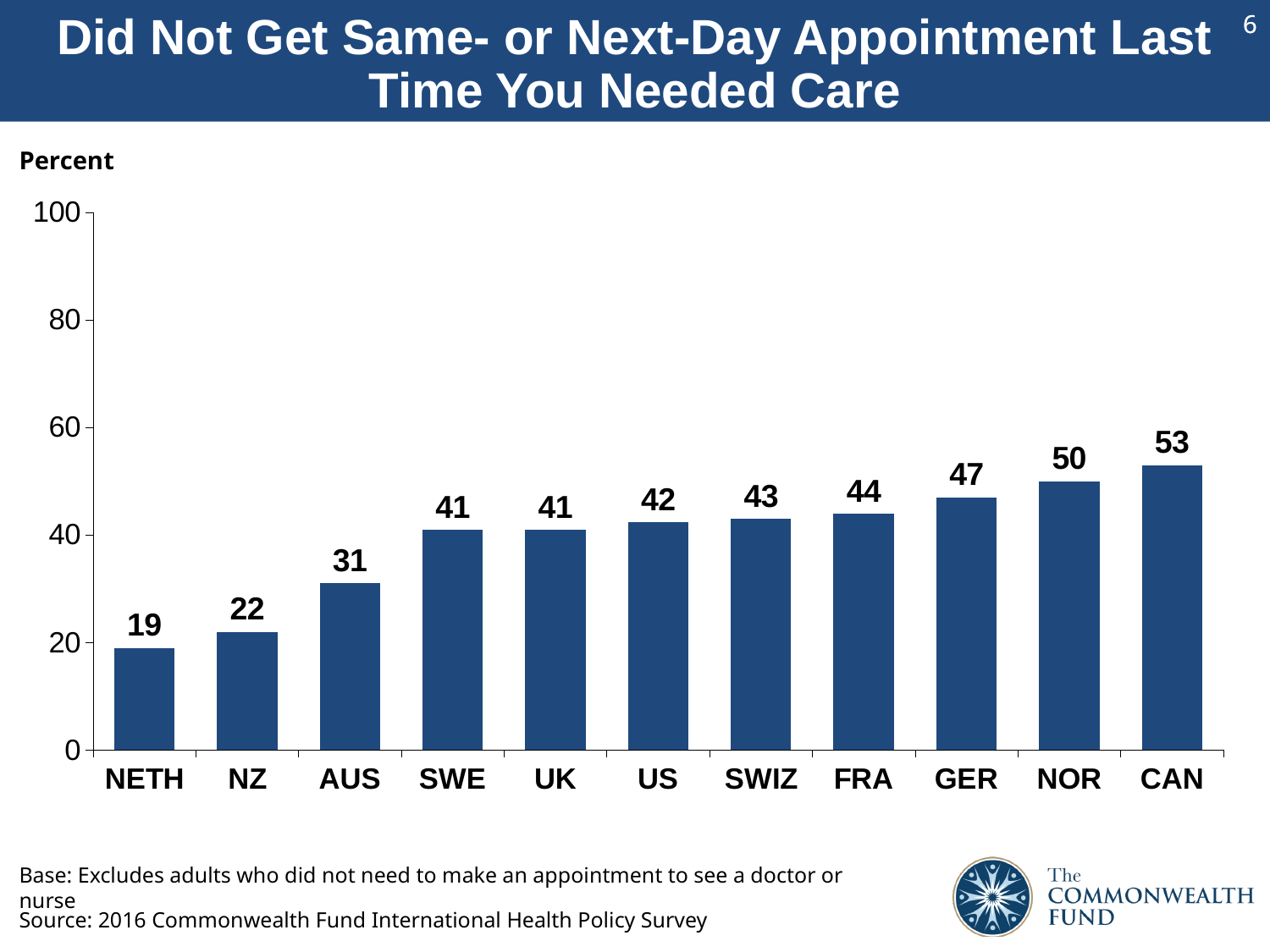
Which country has the highest value? CAN What kind of chart is shown on the slide? bar chart What is the value for CAN? 53 What is the value for GER? 47 Which is larger, the value for FRA or the value for US? FRA How many countries are shown on the chart? 11 Do the values rise or fall from left to right across the x axis? rise What is the value for NETH? 19 What is the difference between the values for NOR and AUS? 19 Which country has the lowest value? NETH Is the value for SWIZ greater or less than 40? greater What is the difference between the values for CAN and NETH? 34